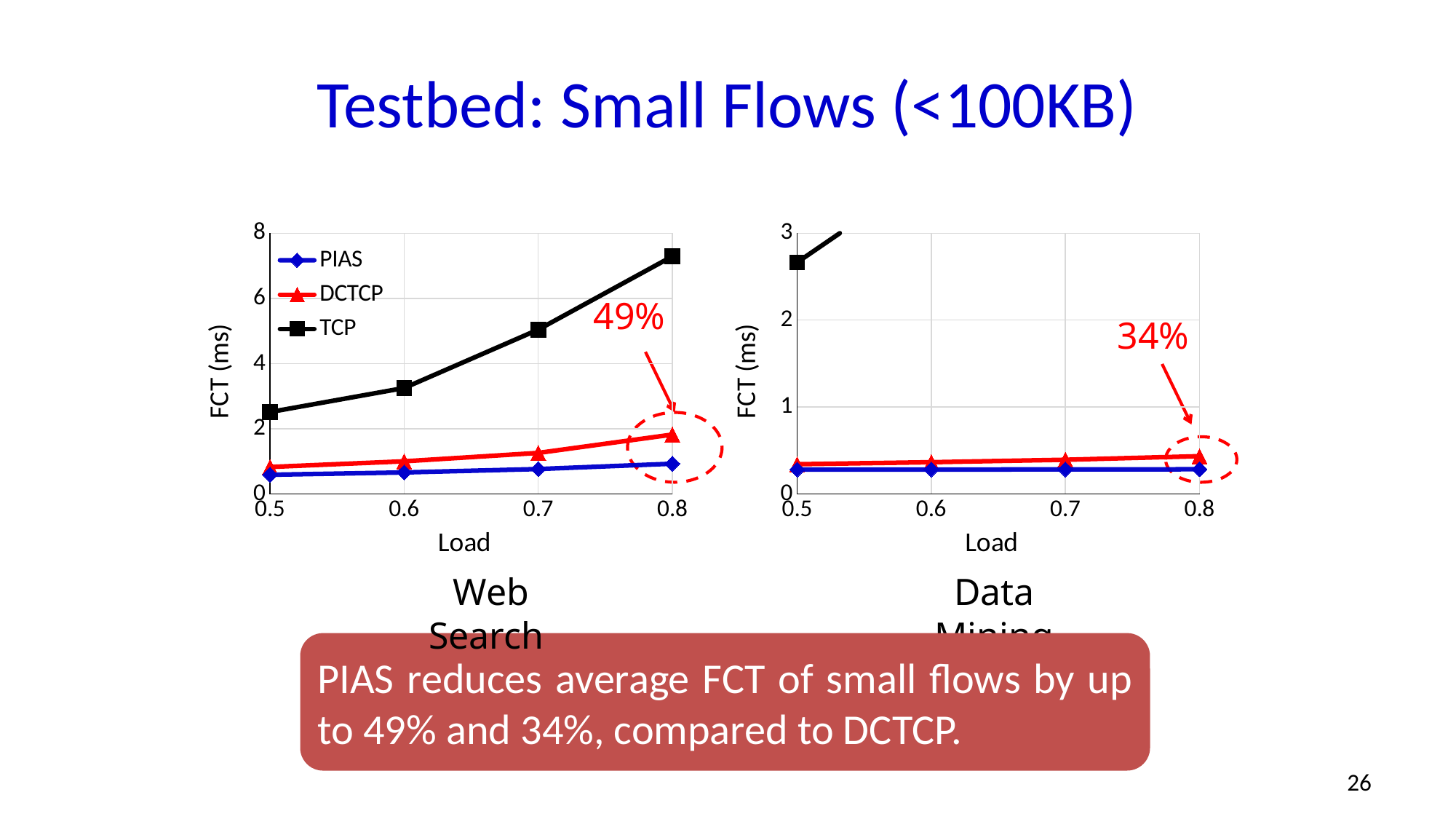
What percentage reduction is annotated on the Data Mining chart? 34% In the Web Search chart, is the TCP value at load 0.8 greater or less than 6? greater In the Web Search chart, which series has the highest FCT at load 0.8? TCP What is the y-axis label of the Web Search chart? FCT (ms) In the Web Search chart, how many load values are plotted along the x axis? 4 In the Web Search chart, which is larger at load 0.7: TCP or DCTCP? TCP In the Web Search chart, is the DCTCP value at load 0.8 greater or less than 2? less How many series does the legend of the Web Search chart list? 3 In the Web Search chart, which series has the lowest FCT at load 0.8? PIAS In the Web Search chart, does the TCP line rise or fall as load increases from 0.5 to 0.8? Rises What kind of chart is the Web Search chart on the left? Line chart In the Data Mining chart, is the TCP value at load 0.5 greater or less than 2? greater